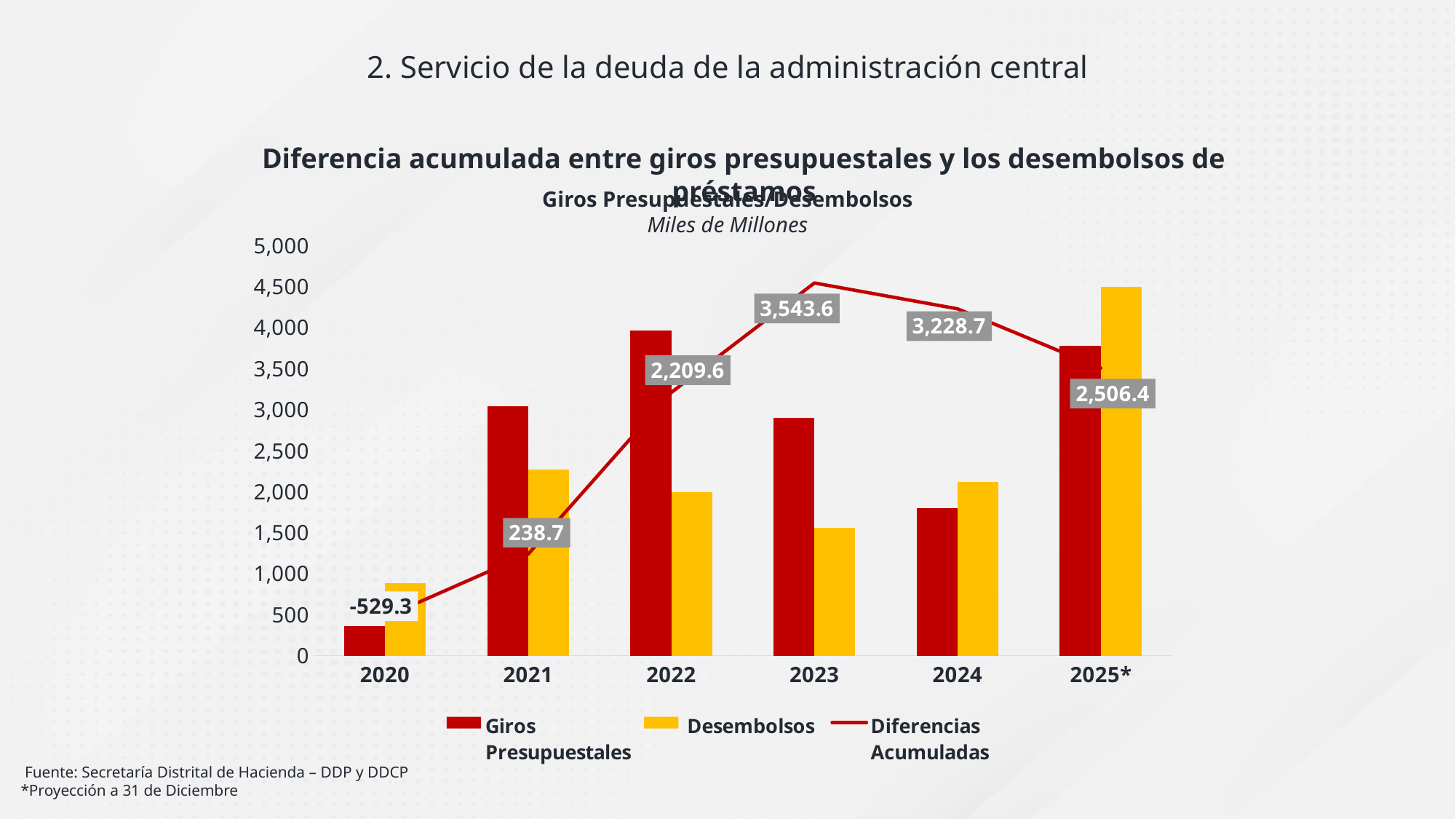
What is the difference between Diferencias Acumuladas in 2023 and 2024? 314.9 Is the value of Giros Presupuestales for 2024 greater or less than 2,000? less How many years are shown on the x axis? 6 What is the value of Diferencias Acumuladas for 2025*? 2,506.4 In which year is Diferencias Acumuladas lowest? 2020 Is the value of Desembolsos for 2025* greater or less than 4,000? greater In which year is Diferencias Acumuladas highest? 2023 What is the value of Diferencias Acumuladas for 2023? 3,543.6 Does Diferencias Acumuladas rise or fall from 2020 to 2023? rise What is the value of Diferencias Acumuladas for 2020? -529.3 In 2025*, which is larger: Giros Presupuestales or Desembolsos? Desembolsos How many series does the legend list? 3